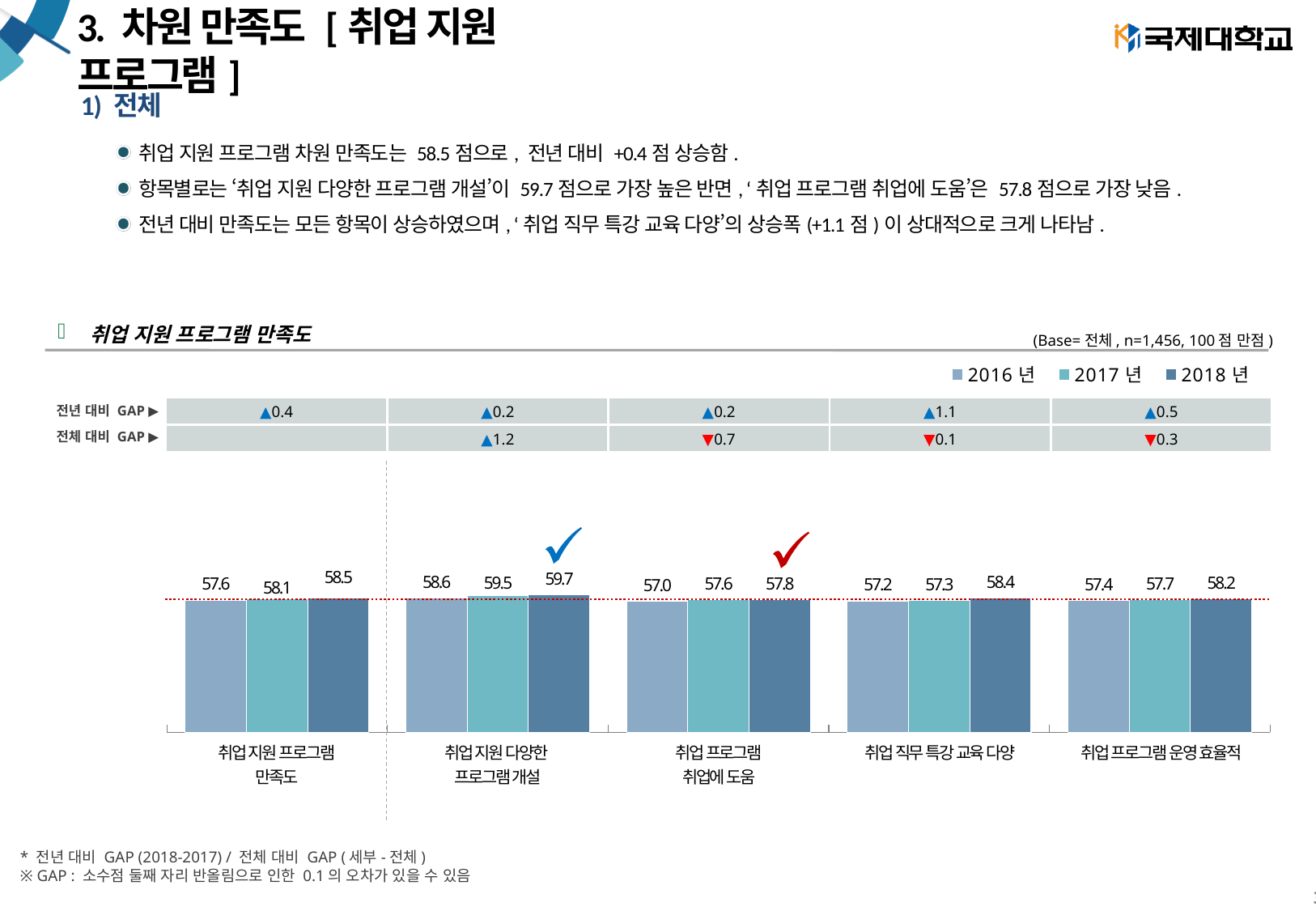
What is the 2017년 value for 취업 직무 특강 교육 다양? 57.3 What is the difference between the 2018년 and 2017년 values for 취업 직무 특강 교육 다양? 1.1 Which is larger: the 2018년 value for 취업 프로그램 운영 효율적 or the 2018년 value for 취업 프로그램 취업에 도움? 취업 프로그램 운영 효율적 Which category has the highest 2018년 value? 취업 지원 다양한 프로그램 개설 Do the values for 취업 프로그램 운영 효율적 rise or fall from 2016년 to 2018년? Rise What is the 2018년 value for 취업 지원 다양한 프로그램 개설? 59.7 What is the 2018년 value for 취업 지원 프로그램 만족도? 58.5 How many categories are shown on the x axis of the chart? 5 What is the 2016년 value for 취업 프로그램 취업에 도움? 57.0 Which category has the lowest 2016년 value? 취업 프로그램 취업에 도움 How many series does the legend list? 3 What kind of chart is shown on the slide? Bar chart